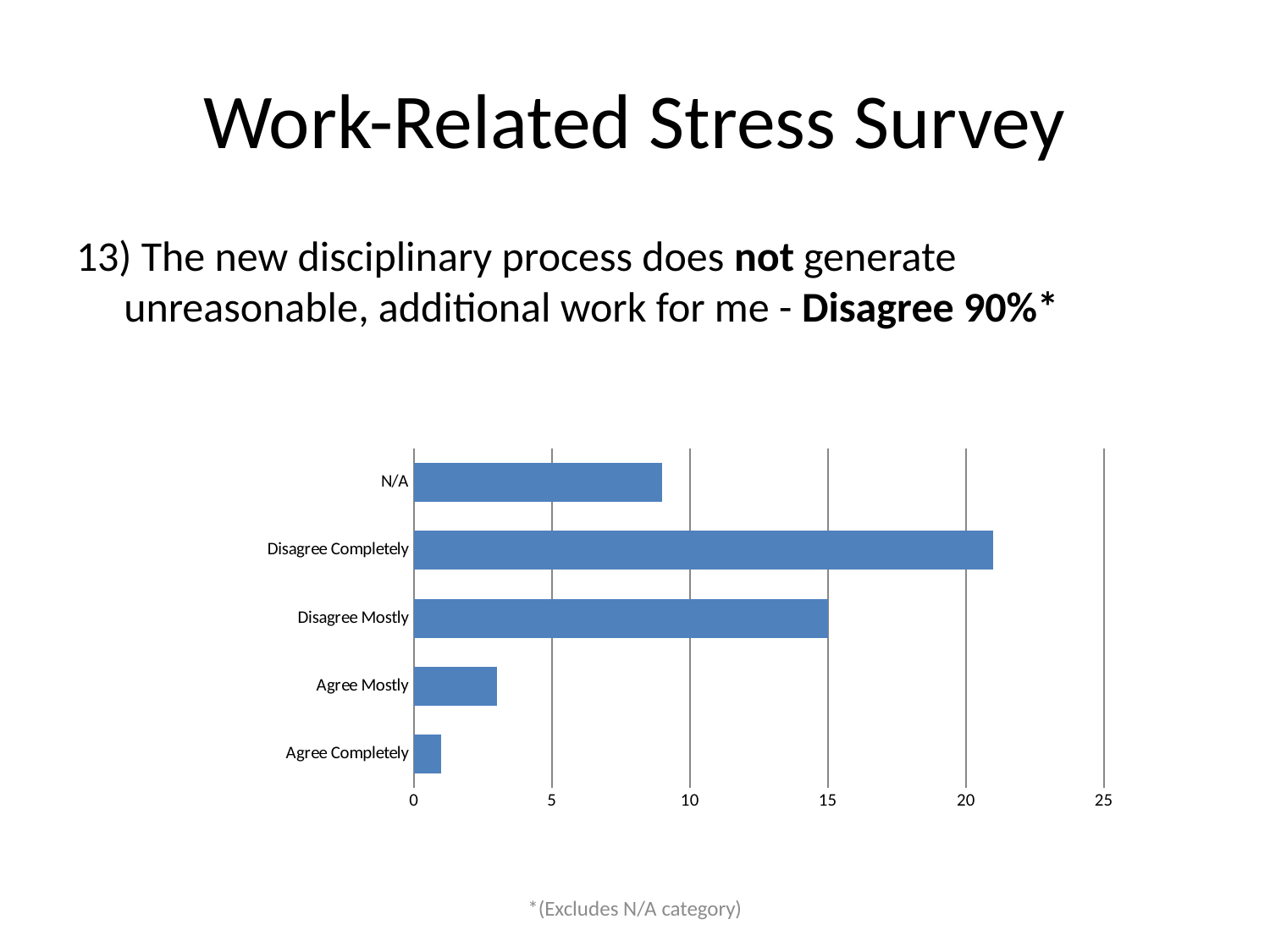
How many categories are shown on the chart? 5 Is the value for Disagree Completely greater or less than 20? greater Is the value for N/A greater or less than 10? less Which is larger, the value for N/A or the value for Disagree Mostly? Disagree Mostly Is the value for Agree Mostly greater or less than 5? less What kind of chart is shown on the slide? bar chart Which category has the lowest value? Agree Completely What is the value for Disagree Mostly? 15 Which is larger, the value for Agree Mostly or the value for Agree Completely? Agree Mostly What is the highest value shown on the horizontal axis? 25 Which category has the highest value? Disagree Completely